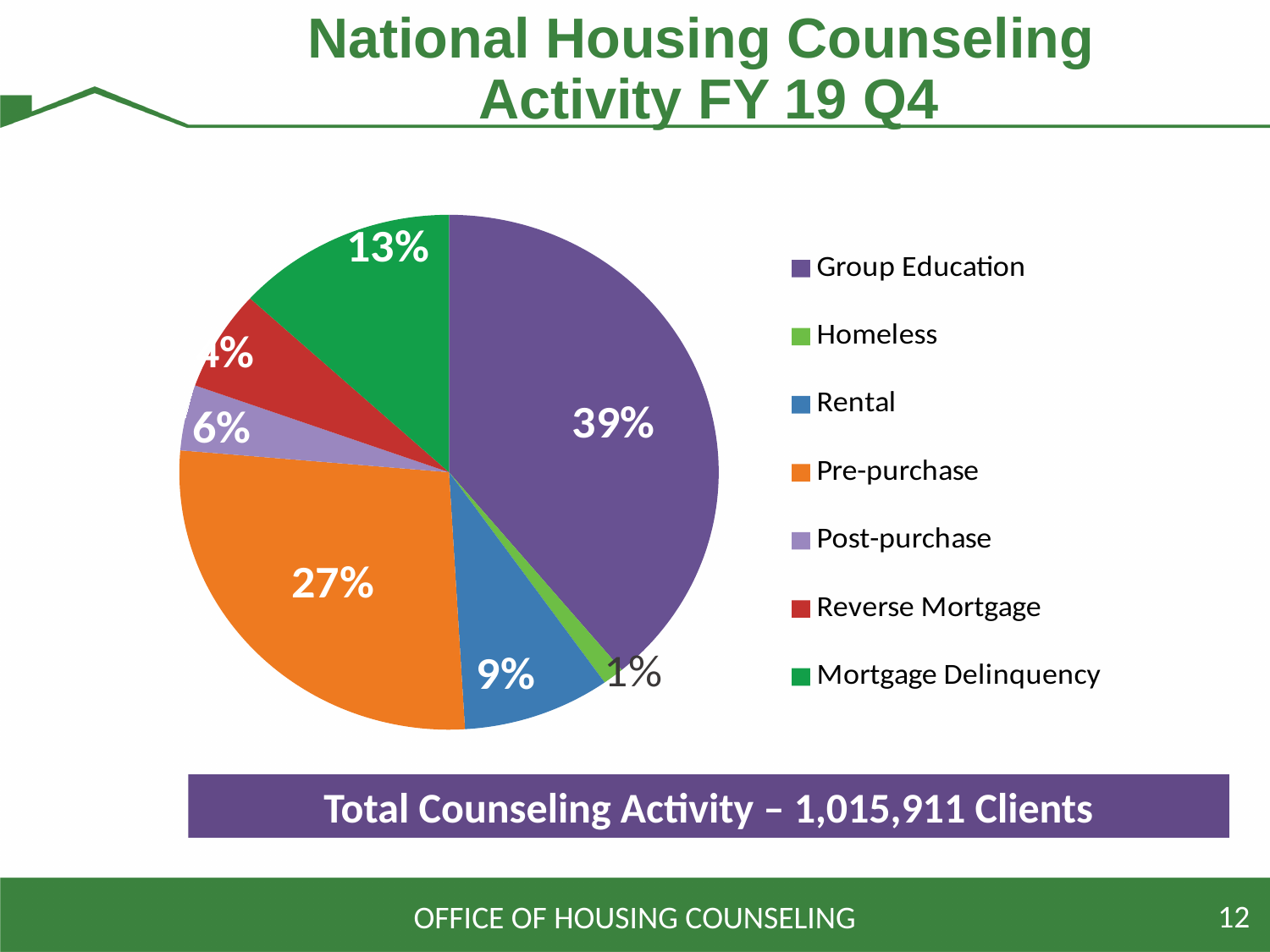
What type of chart is shown on the slide? pie chart What share of counseling activity is Homeless? 1% Which category has the largest slice of the pie? Group Education Which category has the smallest slice of the pie? Homeless What is the difference in percentage points between Group Education and Pre-purchase? 12 What share of counseling activity is Mortgage Delinquency? 13% What share of counseling activity is Pre-purchase? 27% How many categories does the legend list? 7 Which is larger, the Rental slice or the Mortgage Delinquency slice? Mortgage Delinquency